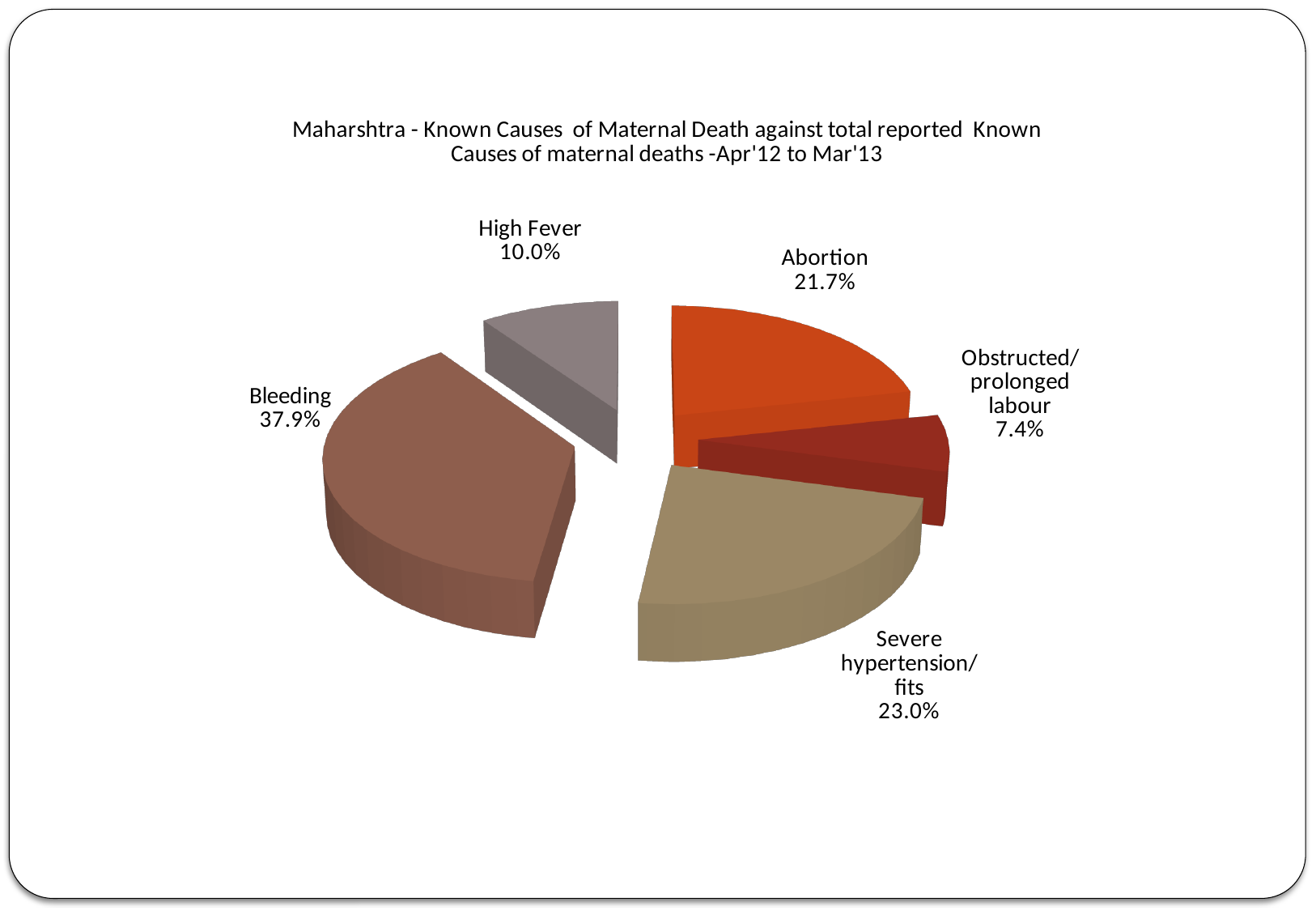
What percentage is shown for Abortion? 21.7% Which has a larger share, Severe hypertension/fits or Abortion? Severe hypertension/fits What share of known causes of maternal death is attributed to Bleeding? 37.9% Which cause accounts for the largest share of maternal deaths? Bleeding What is the difference in percentage points between Bleeding and Abortion? 16.2 How many causes are shown in the pie chart? 5 What percentage is shown for Obstructed/prolonged labour? 7.4% What type of chart is shown on the slide? Pie chart What percentage is shown for High Fever? 10.0% Which cause accounts for the smallest share of maternal deaths? Obstructed/prolonged labour What period does the chart title say the data covers? Apr'12 to Mar'13 What percentage is shown for Severe hypertension/fits? 23.0%